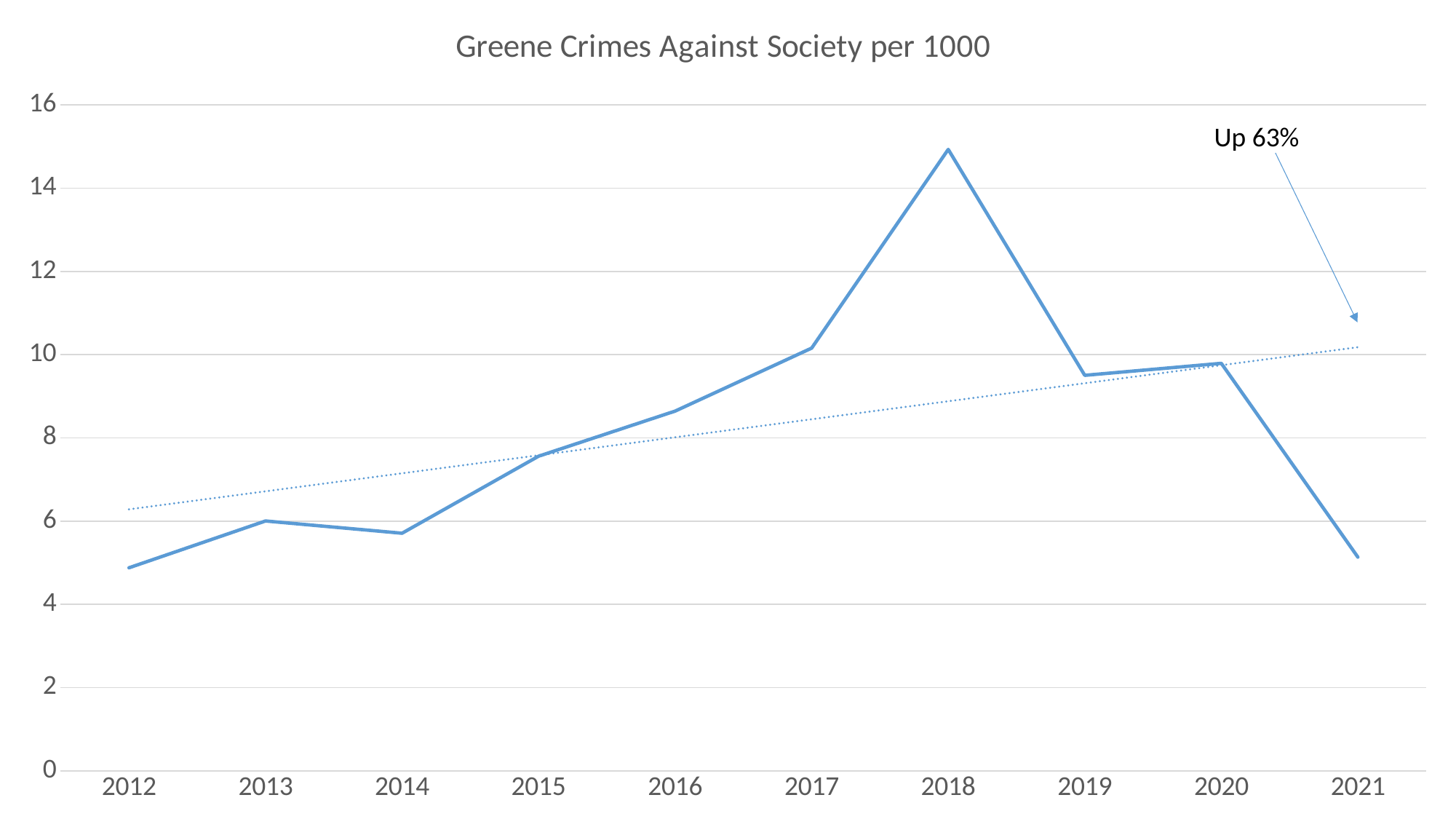
Which year has the highest value? 2018 What does the text annotation pointing to the dotted trendline say? Up 63% Is the value for 2019 greater or less than 10? less Do the values rise or fall from 2018 to 2021? fall What is the title of the chart? Greene Crimes Against Society per 1000 Which year has the larger value, 2016 or 2017? 2017 Which year has the larger value, 2020 or 2021? 2020 How many years are plotted along the x axis? 10 Is the value for 2016 greater or less than 8? greater Is the value for 2012 greater or less than 6? less What kind of chart is shown on the slide? line chart